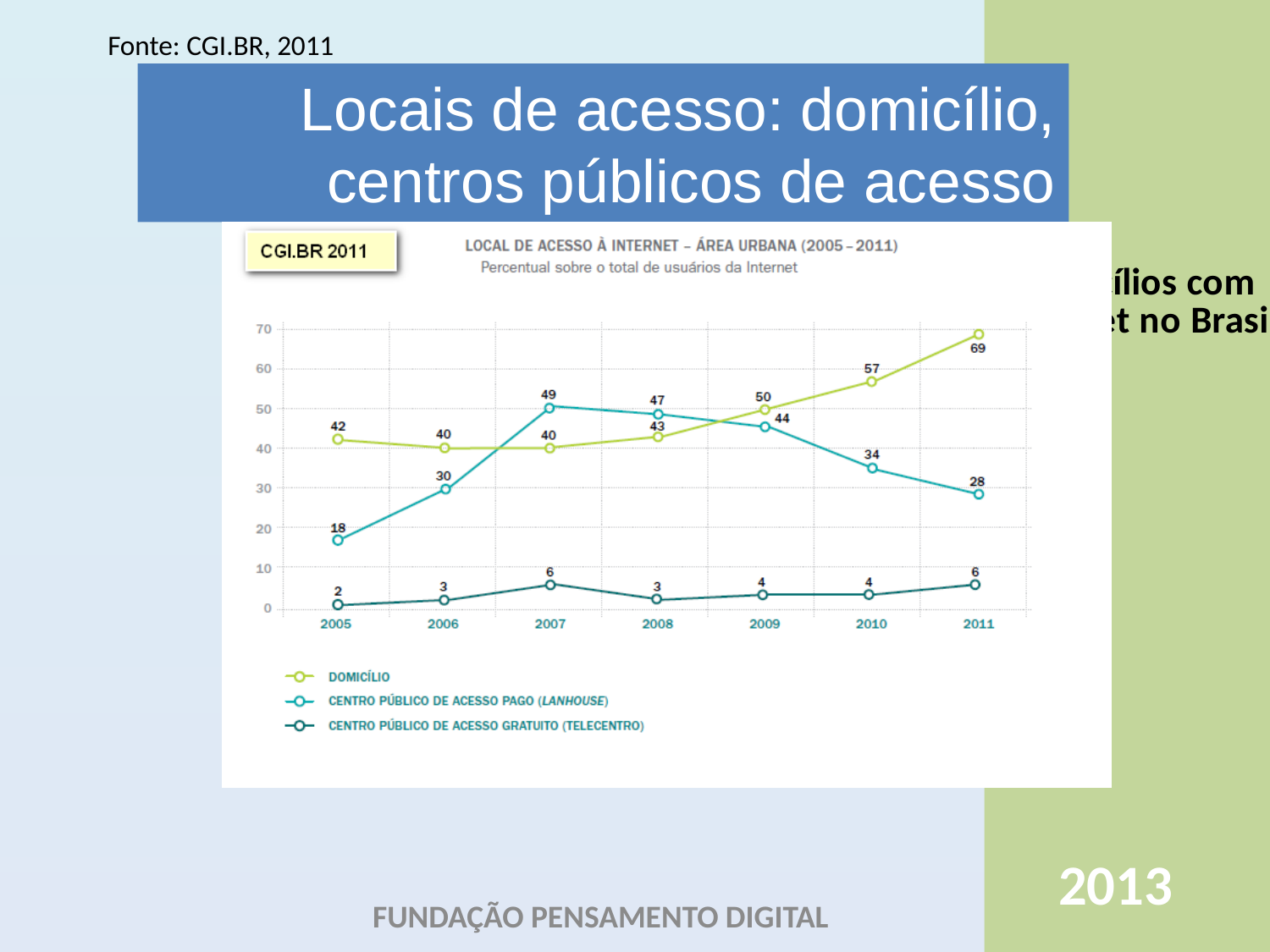
What is the value for CENTRO PÚBLICO DE ACESSO PAGO (LANHOUSE) in 2007? 49 What is the value for CENTRO PÚBLICO DE ACESSO GRATUITO (TELECENTRO) in 2005? 2 What is the difference between the DOMICÍLIO value in 2011 and its value in 2005? 27 Does the CENTRO PÚBLICO DE ACESSO PAGO (LANHOUSE) series rise or fall from 2007 to 2011? Fall In which year does the DOMICÍLIO series reach its highest value? 2011 In 2010, which is larger: DOMICÍLIO or CENTRO PÚBLICO DE ACESSO PAGO (LANHOUSE)? DOMICÍLIO What kind of chart is shown on the slide? Line chart In which year is the CENTRO PÚBLICO DE ACESSO PAGO (LANHOUSE) series at its lowest value? 2005 What is the value for DOMICÍLIO in 2011? 69 What is the title of the chart? LOCAL DE ACESSO À INTERNET – ÁREA URBANA (2005 – 2011) How many years are plotted along the x axis? 7 How many series does the legend list? 3